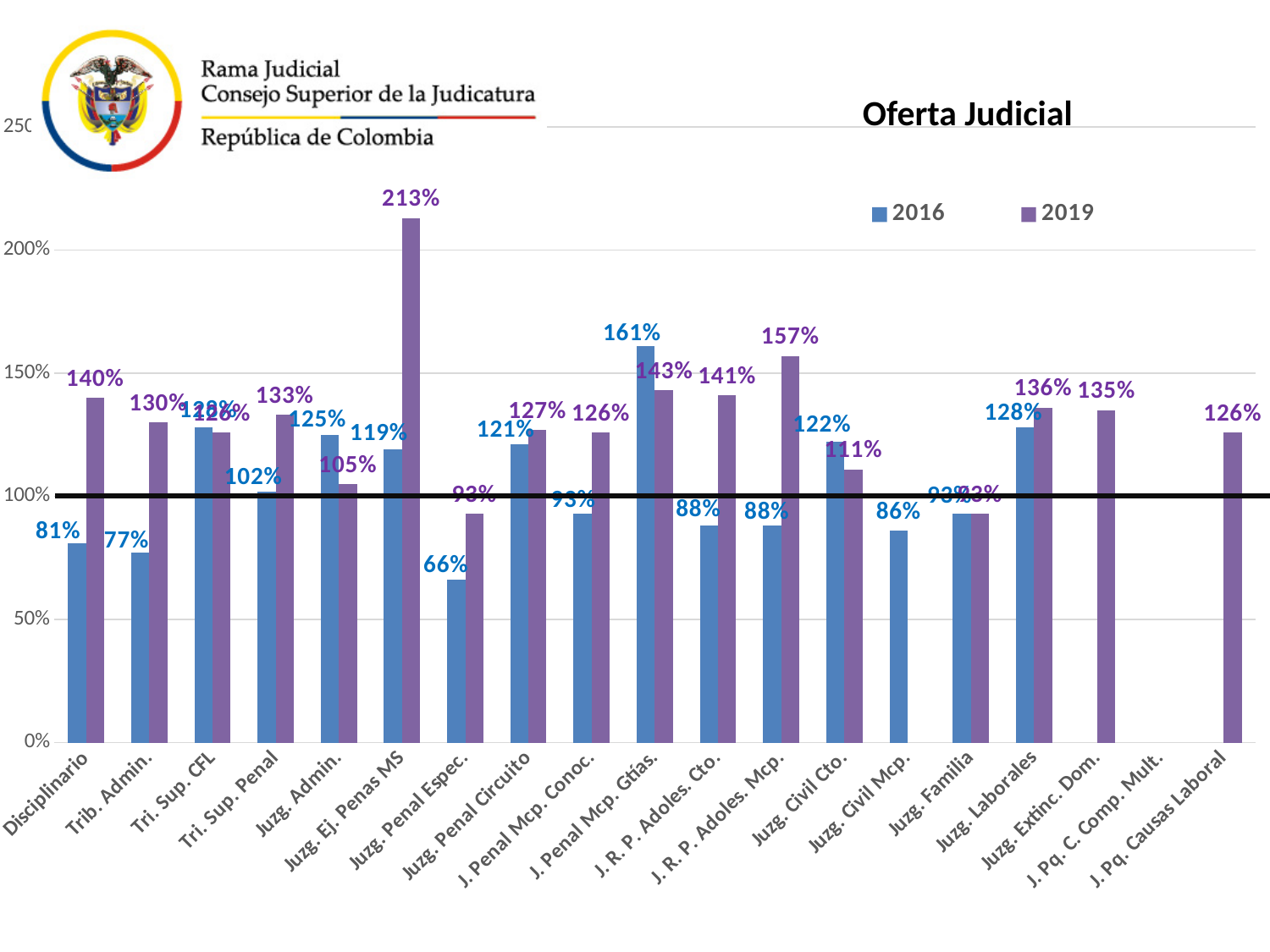
What is the 2019 value for Juzg. Ej. Penas MS? 213% How many series does the legend list? 2 Which category has the highest 2019 value? Juzg. Ej. Penas MS Which category has the lowest 2016 value? Juzg. Penal Espec. What is the difference between the 2019 and 2016 values for Disciplinario? 59% What is the 2019 value for J. R. P. Adoles. Mcp.? 157% What is the title of the chart? Oferta Judicial What is the 2016 value for Disciplinario? 81% Which is larger for Juzg. Admin., the 2016 value or the 2019 value? 2016 Which category has the highest 2016 value? J. Penal Mcp. Gtías. Is the 2016 value for Juzg. Civil Mcp. greater or less than 100%? less What type of chart is shown on the slide? bar chart